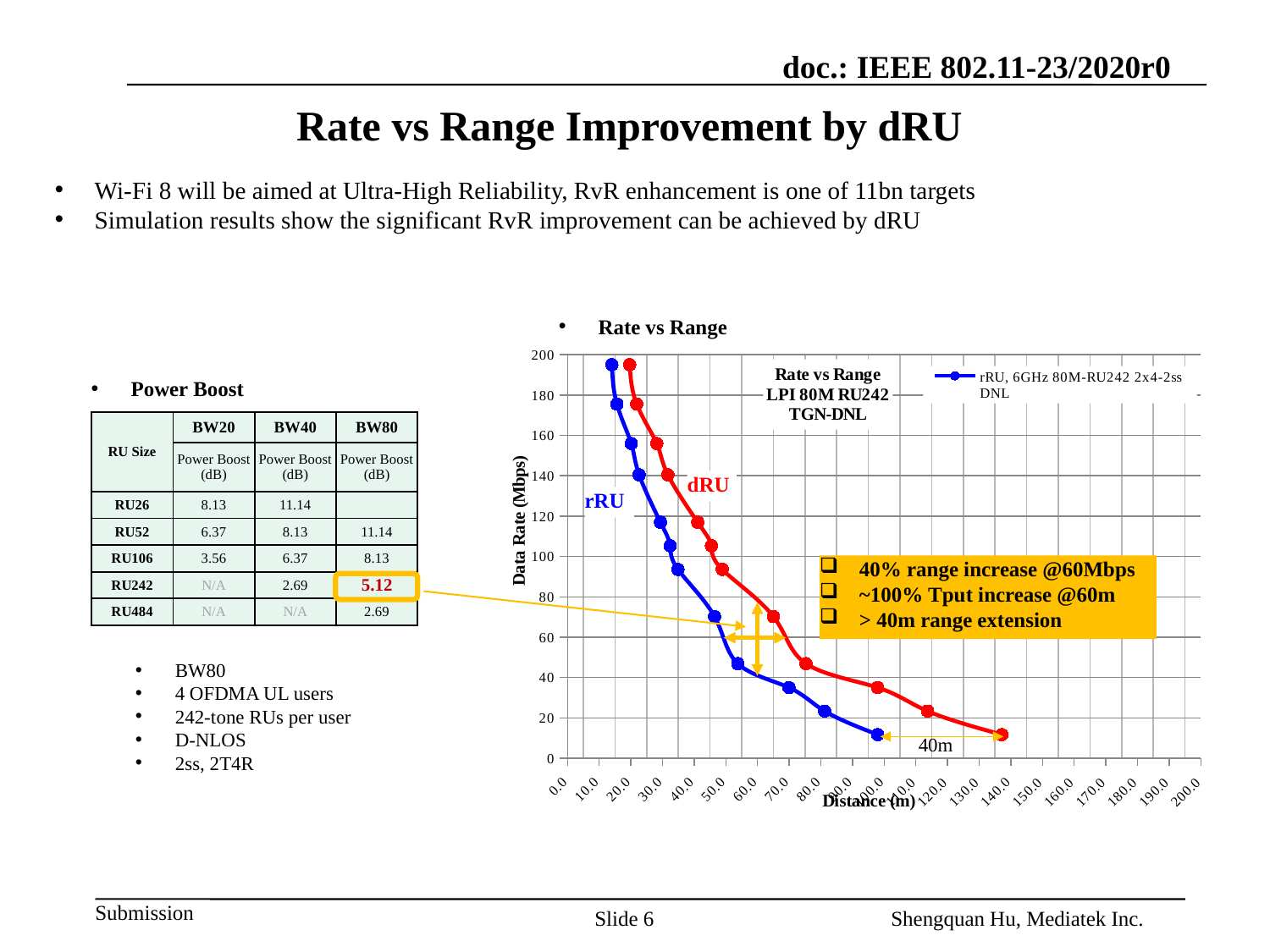
At a distance of 60 m, which series has the higher data rate, rRU or dRU? dRU What is the label of the vertical axis of the chart? Data Rate (Mbps) As distance increases along the x axis, does the data rate rise or fall? fall Which series reaches the greater maximum distance, rRU or dRU? dRU Is the data rate of the first (closest) rRU point greater or less than 180 Mbps? greater Is the data rate of the farthest dRU point greater or less than 20 Mbps? less Which series has the lower data rate at a distance of 80 m, rRU or dRU? rRU Is the distance of the farthest rRU point greater or less than 120 m? less What kind of chart is shown on the slide? line chart What is the title of the chart on the slide? Rate vs Range LPI 80M RU242 TGN-DNL